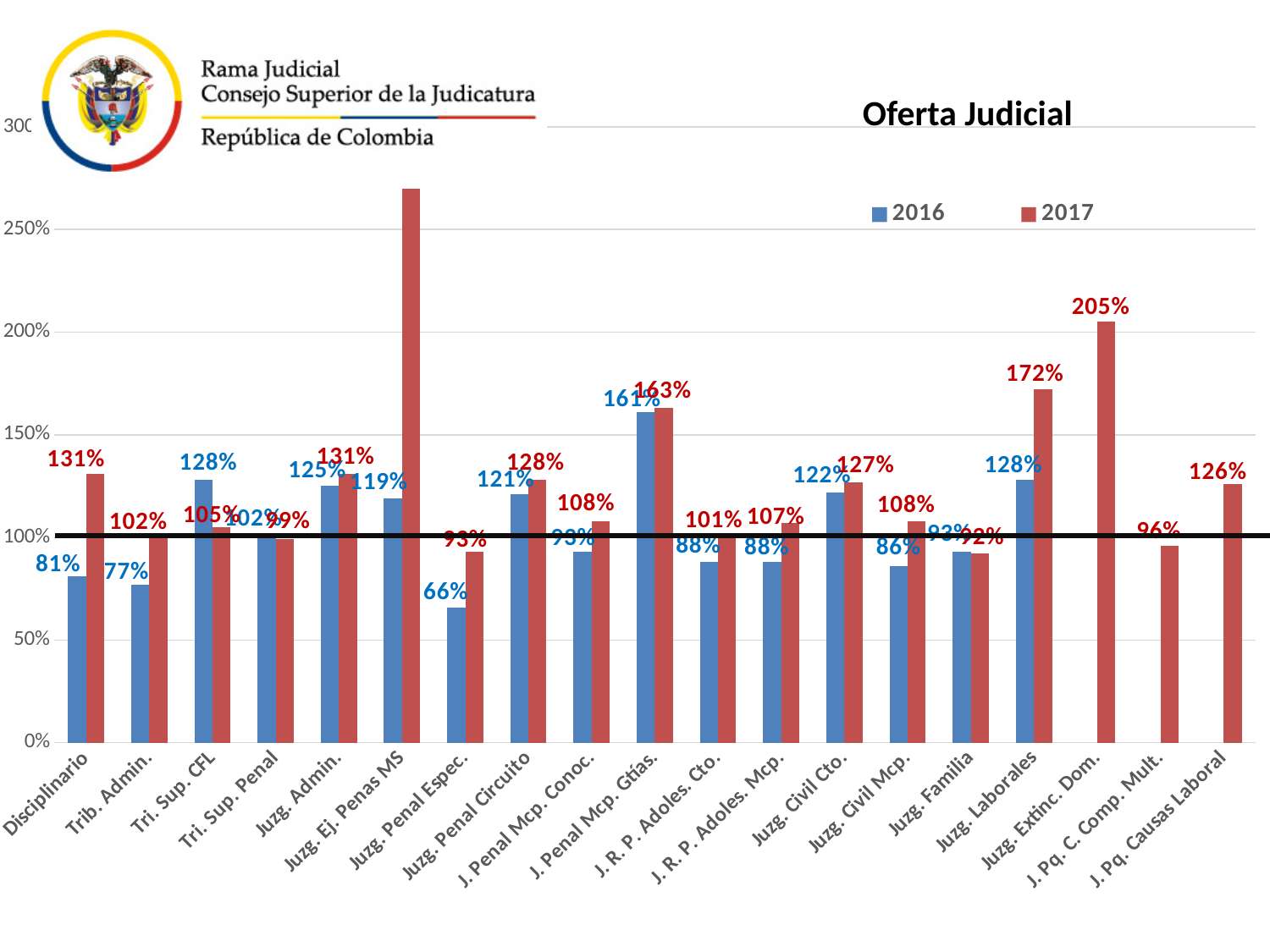
What is the 2017 value for Juzg. Laborales? 172% What is the 2017 value for Juzg. Extinc. Dom.? 205% What type of chart is shown on the slide? Bar chart Is the 2017 value for Juzg. Ej. Penas MS greater or less than 250%? greater What is the difference between the 2017 and 2016 values for Juzg. Laborales? 44 percentage points What is the 2016 value for Disciplinario? 81% Which category has the lowest 2016 value? Juzg. Penal Espec. For Tri. Sup. CFL, which year has the larger value, 2016 or 2017? 2016 How many series does the legend list? 2 What is the 2016 value for Juzg. Penal Espec.? 66% How many categories are shown on the x axis? 19 Which category has the highest 2017 value? Juzg. Ej. Penas MS